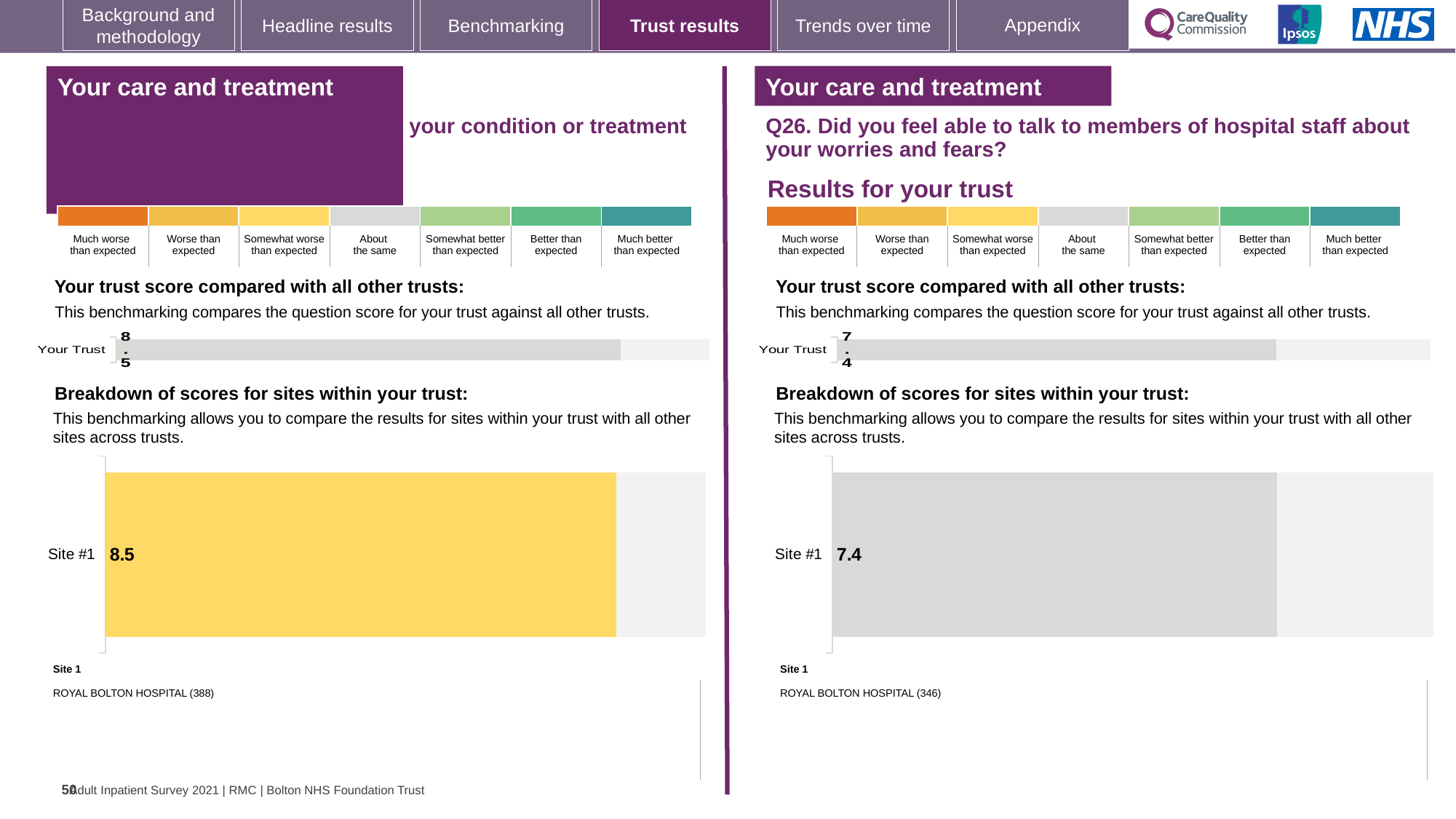
Is the Your Trust score on the right panel (Q26) greater or less than the Your Trust score on the left panel? less On the right panel (Q26), which benchmark category does the grey colour of the Site #1 bar correspond to in the legend? About the same What is the difference between the Site #1 score on the left panel and the Site #1 score on the right panel (Q26)? 1.1 On the left panel, what is the score shown for Your Trust in the 'Your trust score compared with all other trusts' chart? 8.5 On the right panel (Q26), what is the score shown for Your Trust in the 'Your trust score compared with all other trusts' chart? 7.4 On the right panel (Q26), what is the score shown for Site #1 in the 'Breakdown of scores for sites within your trust' chart? 7.4 Which is larger: the Site #1 score on the left panel or the Site #1 score on the right panel (Q26)? Left panel (8.5) What type of chart is used to show the Site #1 score on the left panel? Bar chart Which site name is listed as Site 1 on the right panel (Q26)? ROYAL BOLTON HOSPITAL (346) On the left panel, what colour is the Site #1 bar in the 'Breakdown of scores for sites within your trust' chart? Yellow On the left panel, what is the score shown for Site #1 in the 'Breakdown of scores for sites within your trust' chart? 8.5 How many sites are shown in the 'Breakdown of scores for sites within your trust' chart on the right panel (Q26)? 1